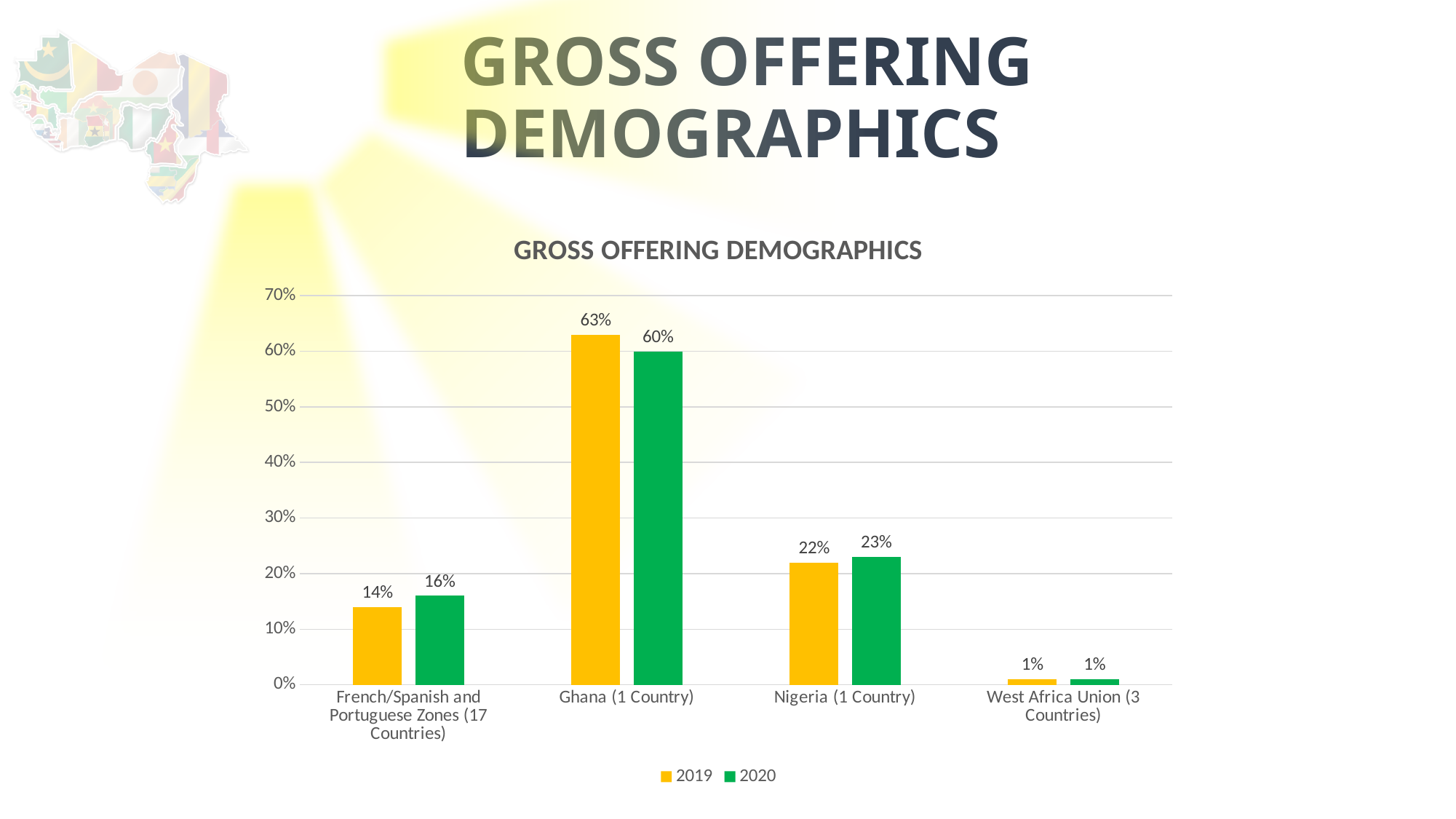
What is the 2020 value for Nigeria (1 Country)? 23% Which is larger for Nigeria (1 Country): the 2019 value or the 2020 value? 2020 Is the 2019 value for Ghana (1 Country) greater or less than 50%? greater What is the title of the chart? GROSS OFFERING DEMOGRAPHICS Which category has the highest 2020 value? Ghana (1 Country) What kind of chart is shown on the slide? Bar chart What is the 2020 value for French/Spanish and Portuguese Zones (17 Countries)? 16% How many categories are shown on the x axis? 4 How many series does the legend list? 2 What is the difference between the 2019 and 2020 values for Ghana (1 Country)? 3% Which category has the lowest 2019 value? West Africa Union (3 Countries) What is the 2019 value for Ghana (1 Country)? 63%